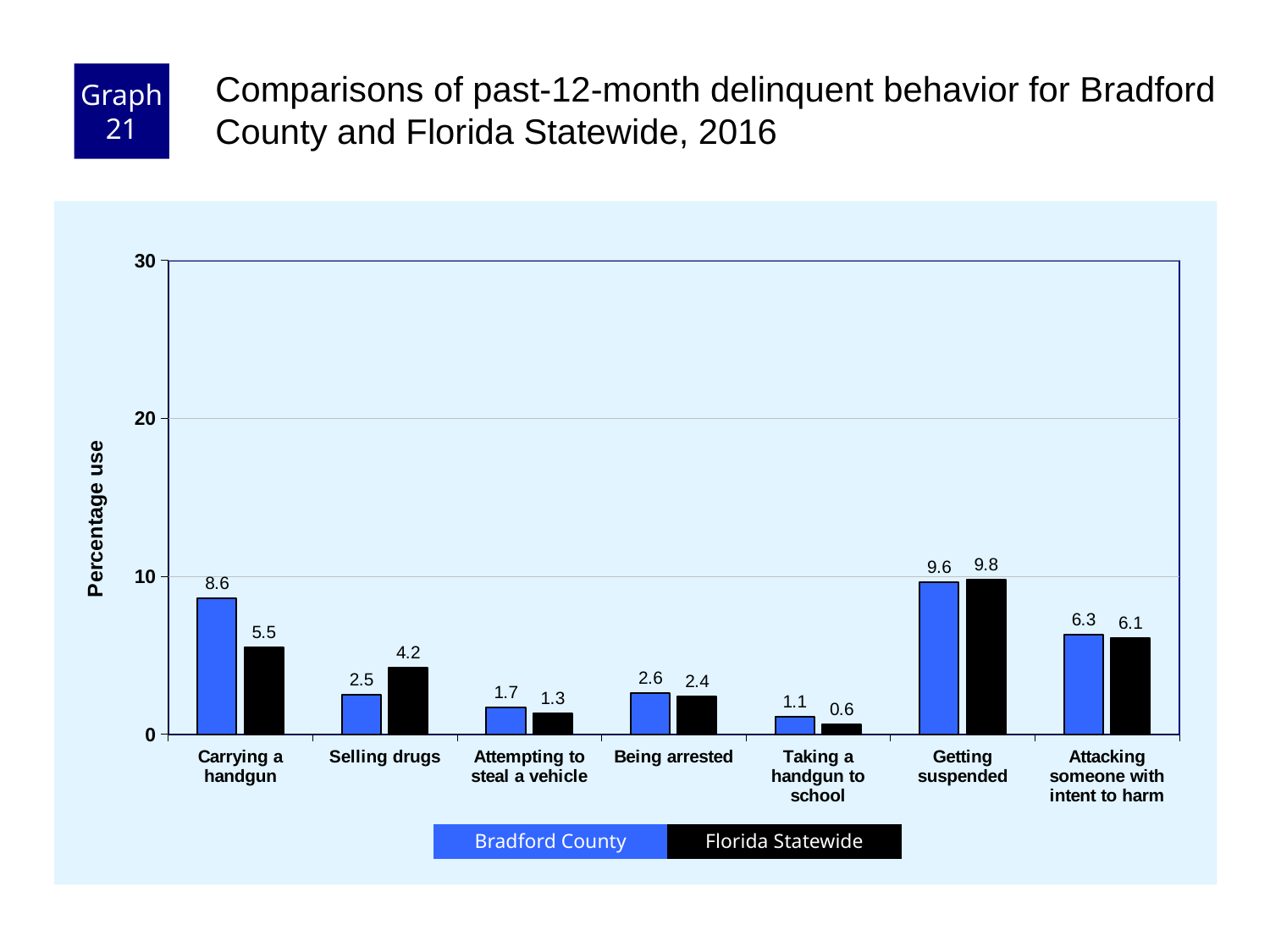
How many series does the legend list? 2 Which is larger for Selling drugs: Bradford County or Florida Statewide? Florida Statewide Which category has the lowest Bradford County value? Taking a handgun to school Is the Bradford County value for Getting suspended greater or less than 10? less What is the Bradford County value for Taking a handgun to school? 1.1 What kind of chart is shown on the slide? bar chart What is the difference between the Bradford County and Florida Statewide values for Carrying a handgun? 3.1 What is the Florida Statewide value for Selling drugs? 4.2 How many categories are shown on the x axis? 7 Which category has the highest Florida Statewide value? Getting suspended What is the label of the y axis? Percentage use What is the Bradford County value for Carrying a handgun? 8.6